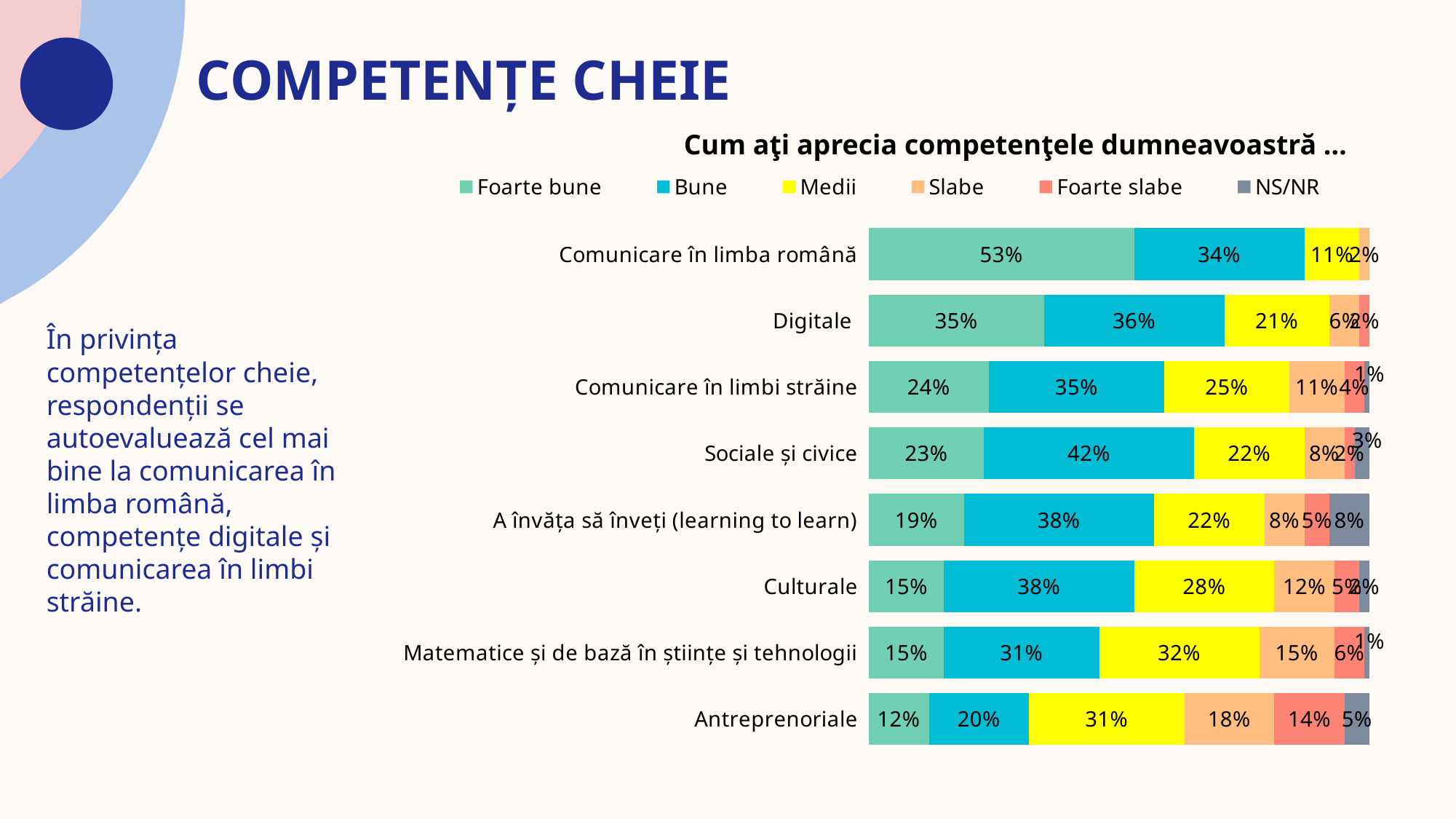
What is the difference between the 'Foarte bune' values for 'Digitale' and 'Comunicare în limbi străine'? 11% What is the 'Medii' value for 'Matematice și de bază în științe și tehnologii'? 32% What type of chart is shown on the slide? Stacked bar chart Which category has the highest 'Foarte bune' share? Comunicare în limba română What is the 'Foarte slabe' value for 'Antreprenoriale'? 14% What percentage of respondents rated their 'Comunicare în limba română' competences as 'Foarte bune'? 53% How many series does the legend list? 6 What is the 'Bune' value for 'Sociale și civice'? 42% How many competence categories are shown in the chart? 8 Which category has the lowest 'Foarte bune' share? Antreprenoriale Which is larger: the 'Medii' value for 'Culturale' or the 'Medii' value for 'Digitale'? Culturale What is the total of all segments in the 'Antreprenoriale' bar? 100%